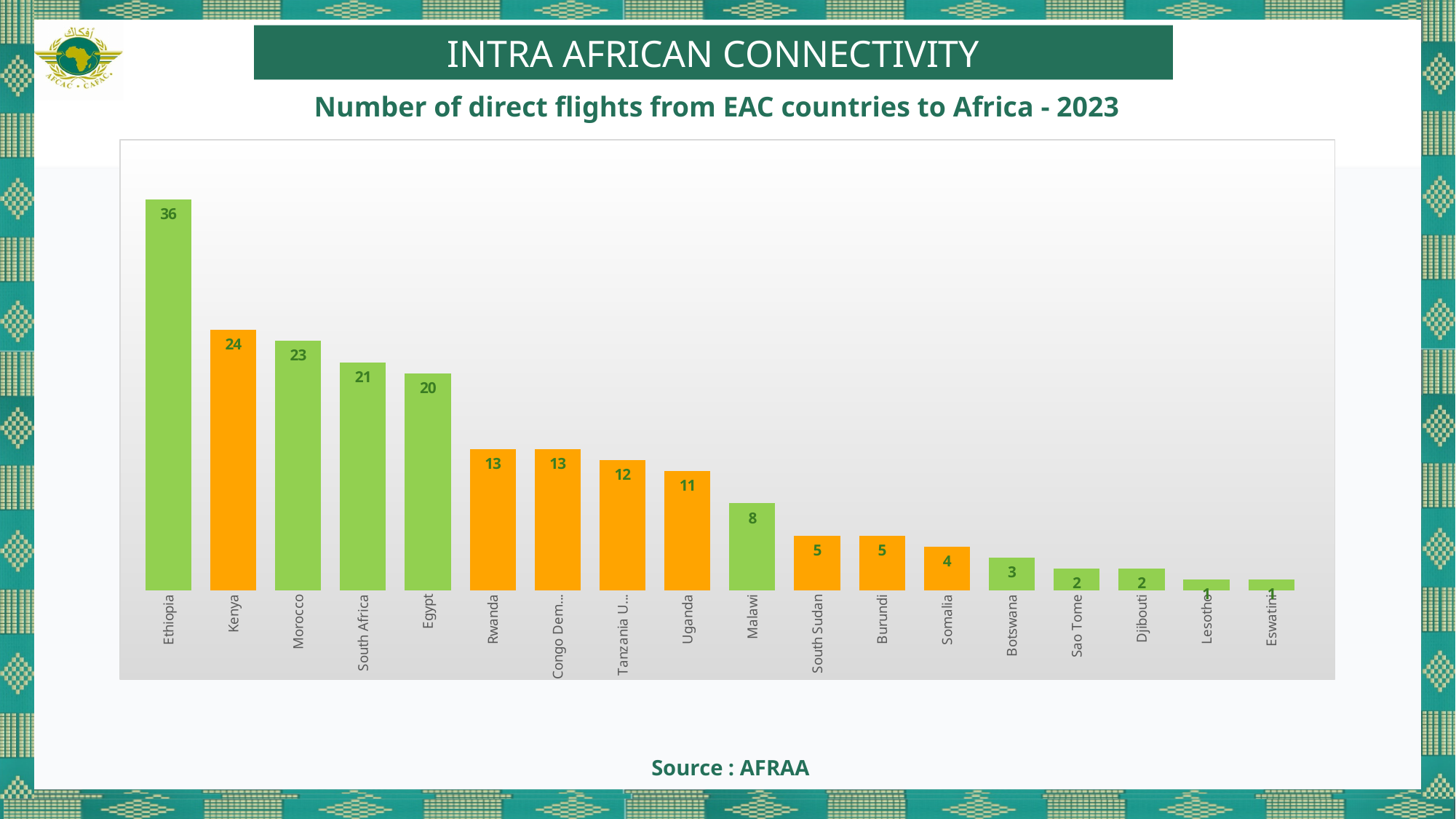
What is the difference between the values for Ethiopia and Kenya? 12 What is the difference between the values for Morocco and Egypt? 3 What is the number of direct flights for Kenya? 24 What is the number of direct flights for Ethiopia? 36 Which has a larger value, Somalia or Botswana? Somalia What is the number of direct flights for Malawi? 8 Which has a larger value, South Africa or Rwanda? South Africa What is the source cited for the chart? AFRAA What is the number of direct flights for Uganda? 11 Which country has the highest number of direct flights? Ethiopia How many countries are shown in the chart? 18 What kind of chart is shown on the slide? Bar chart